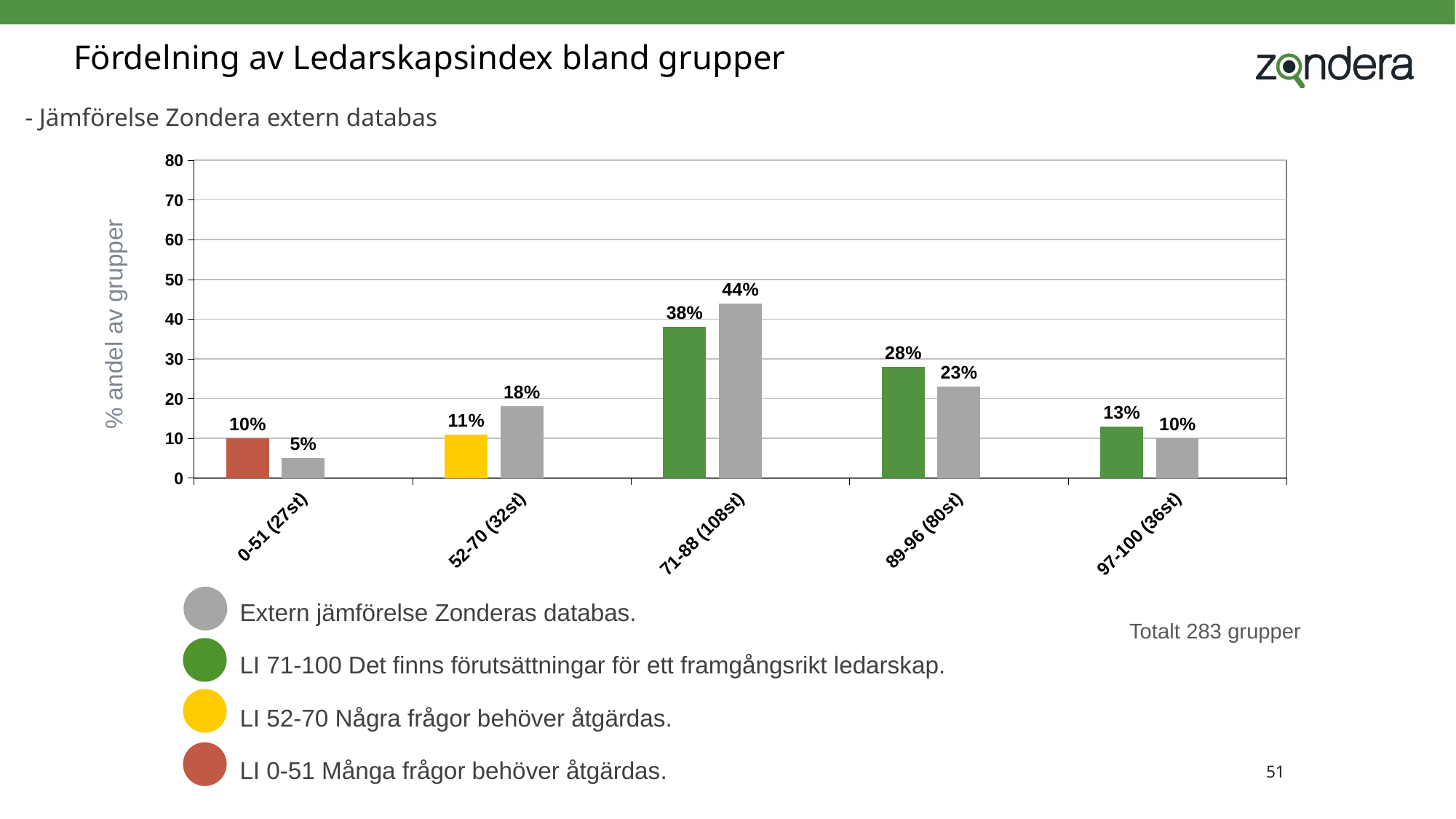
Which category has the lowest grey external comparison value? 0-51 (27st) In the 52-70 (32st) category, which is larger: the yellow bar or the grey external comparison bar? the grey external comparison bar What is the value of the yellow bar for the 52-70 (32st) category? 11% What is the value of the grey external comparison bar for the 0-51 (27st) category? 5% Which category has the highest grey external comparison value? 71-88 (108st) What is the label of the y axis? % andel av grupper What is the difference between the coloured bar and the grey bar in the 71-88 (108st) category? 6% What kind of chart is shown on the slide? bar chart What is the value of the green bar for the 89-96 (80st) category? 28% How many Ledarskapsindex categories are shown on the x axis? 5 How many entries does the legend below the chart list? 4 What is the value of the grey external comparison bar for the 71-88 (108st) category? 44%